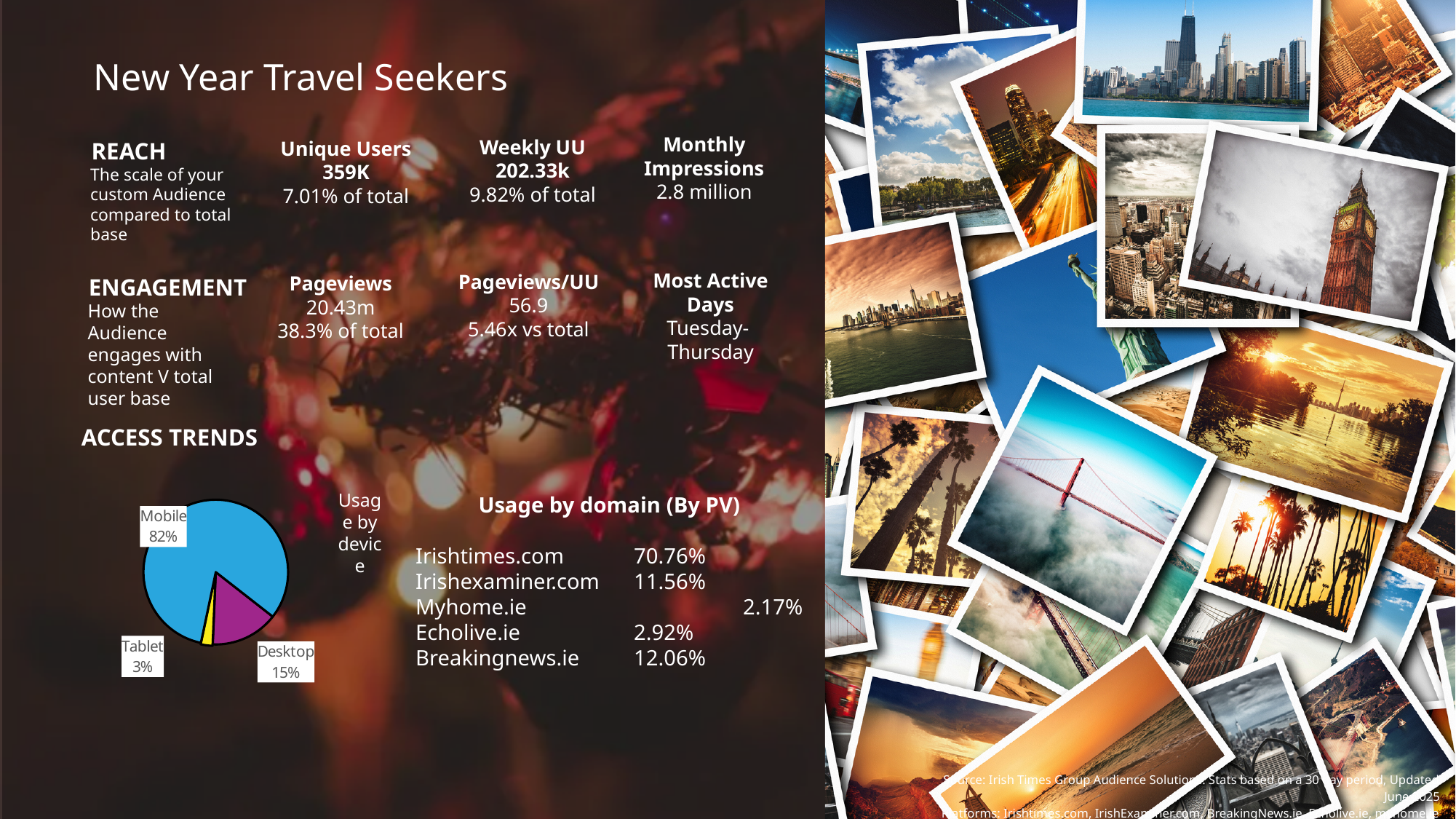
In the "Usage by device" pie chart, what is the difference between the Mobile and Desktop values? 67% What is the value for Mobile in the "Usage by device" pie chart? 82% In the "Usage by device" pie chart, what is the difference between the Desktop and Tablet values? 12% Which device has the largest slice in the "Usage by device" pie chart? Mobile What kind of chart is the "Usage by device" chart? pie chart What colour is the Mobile slice in the "Usage by device" pie chart? blue Which device has the smallest slice in the "Usage by device" pie chart? Tablet How many slices does the "Usage by device" pie chart have? 3 What is the value for Desktop in the "Usage by device" pie chart? 15% What share of the "Usage by device" pie does Mobile account for? 82% In the "Usage by device" pie chart, which is larger, Desktop or Tablet? Desktop What is the value for Tablet in the "Usage by device" pie chart? 3%